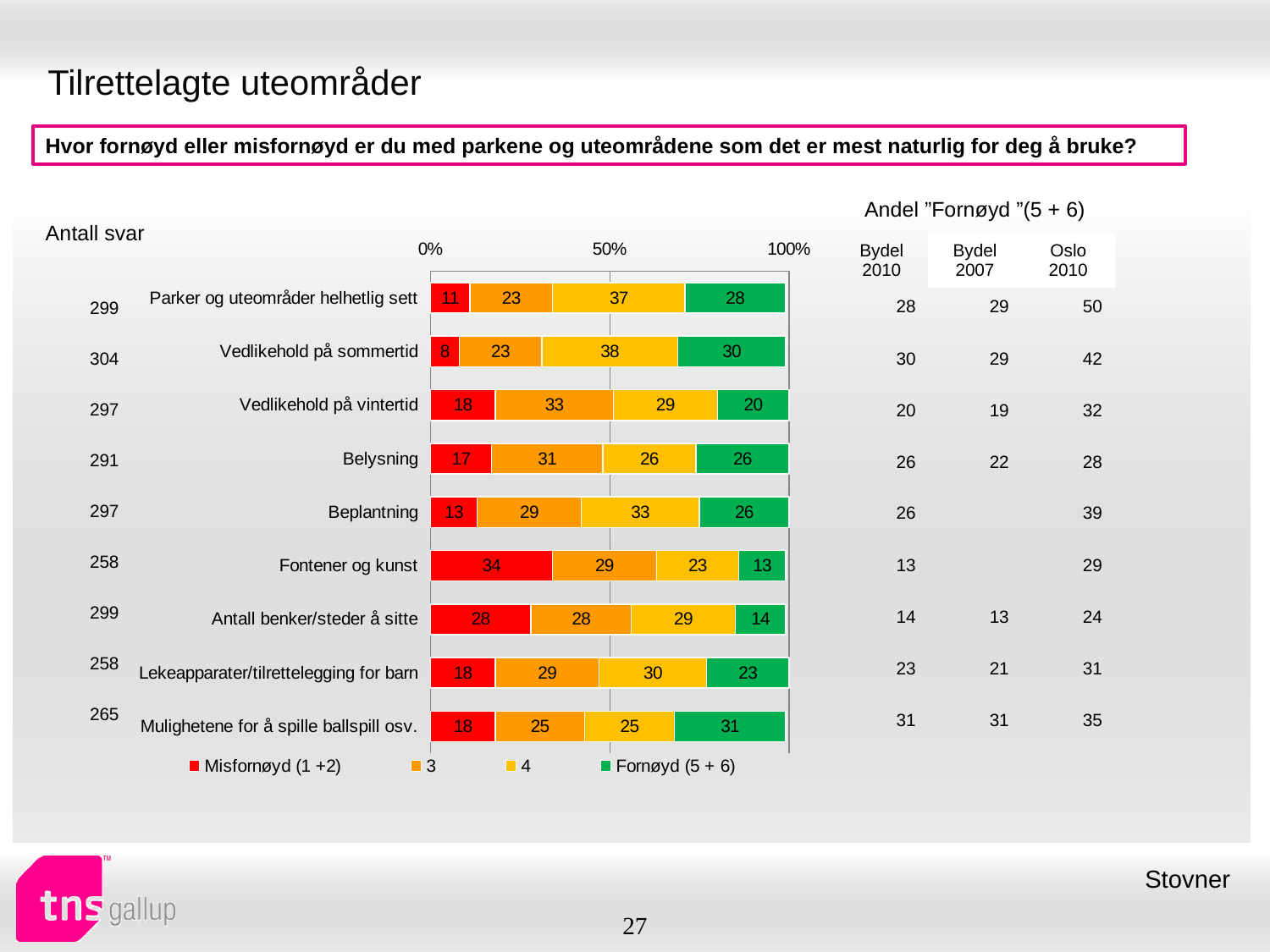
Which has the larger "Misfornøyd (1 +2)" value, "Belysning" or "Beplantning"? Belysning What is the difference between the "Fornøyd (5 + 6)" values for "Parker og uteområder helhetlig sett" and "Antall benker/steder å sitte"? 14 What kind of chart is shown on the slide? Stacked bar chart What is the value of the "Misfornøyd (1 +2)" series for "Fontener og kunst"? 34 Which category has the lowest "Fornøyd (5 + 6)" value? Fontener og kunst Which category has the highest "Fornøyd (5 + 6)" value? Mulighetene for å spille ballspill osv. What is the value of the "Fornøyd (5 + 6)" series for "Vedlikehold på sommertid"? 30 What is the total of the stacked bar for "Vedlikehold på vintertid"? 100 Which category has the lowest "Misfornøyd (1 +2)" value? Vedlikehold på sommertid What is the value of the "4" series for "Parker og uteområder helhetlig sett"? 37 How many series does the legend list? 4 How many categories are shown in the chart? 9